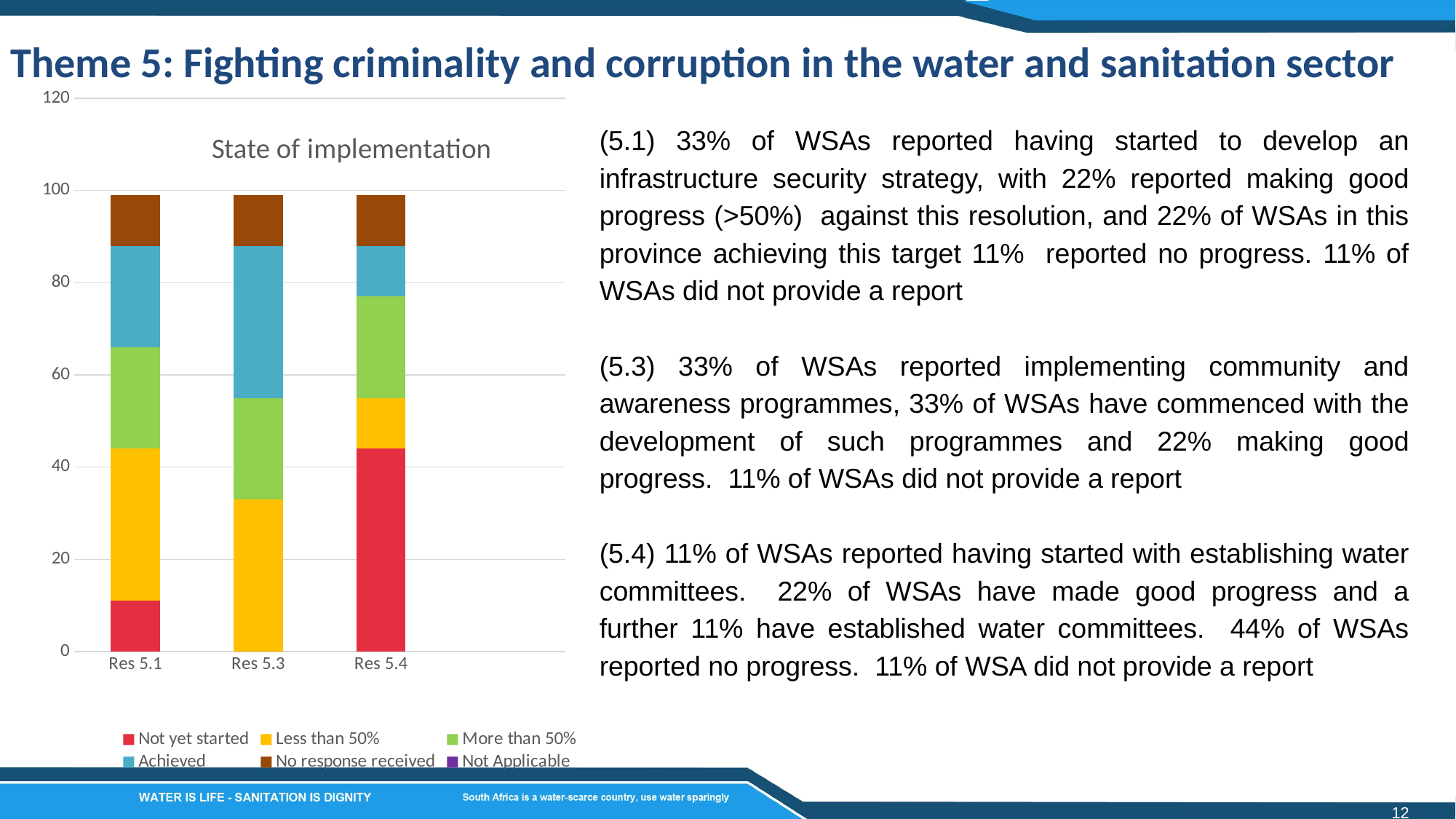
Is the top of the 'Not yet started' segment for Res 5.4 greater or less than 40? greater What kind of chart is shown on the slide? Stacked bar chart Which category has no visible 'Not yet started' segment? Res 5.3 How many categories are shown on the x axis of the chart? 3 Which category has the largest 'Not yet started' segment? Res 5.4 Which legend series does not appear as a visible segment in any bar? Not Applicable How many series does the chart legend list? 6 Is the 'Achieved' segment larger for Res 5.1 or for Res 5.4? Res 5.1 Is the 'Not yet started' segment larger for Res 5.4 or for Res 5.1? Res 5.4 Is the top of the 'Not yet started' segment for Res 5.1 greater or less than 20? less What is the title of the chart? State of implementation Is the total height of the Res 5.3 bar greater or less than 80? greater